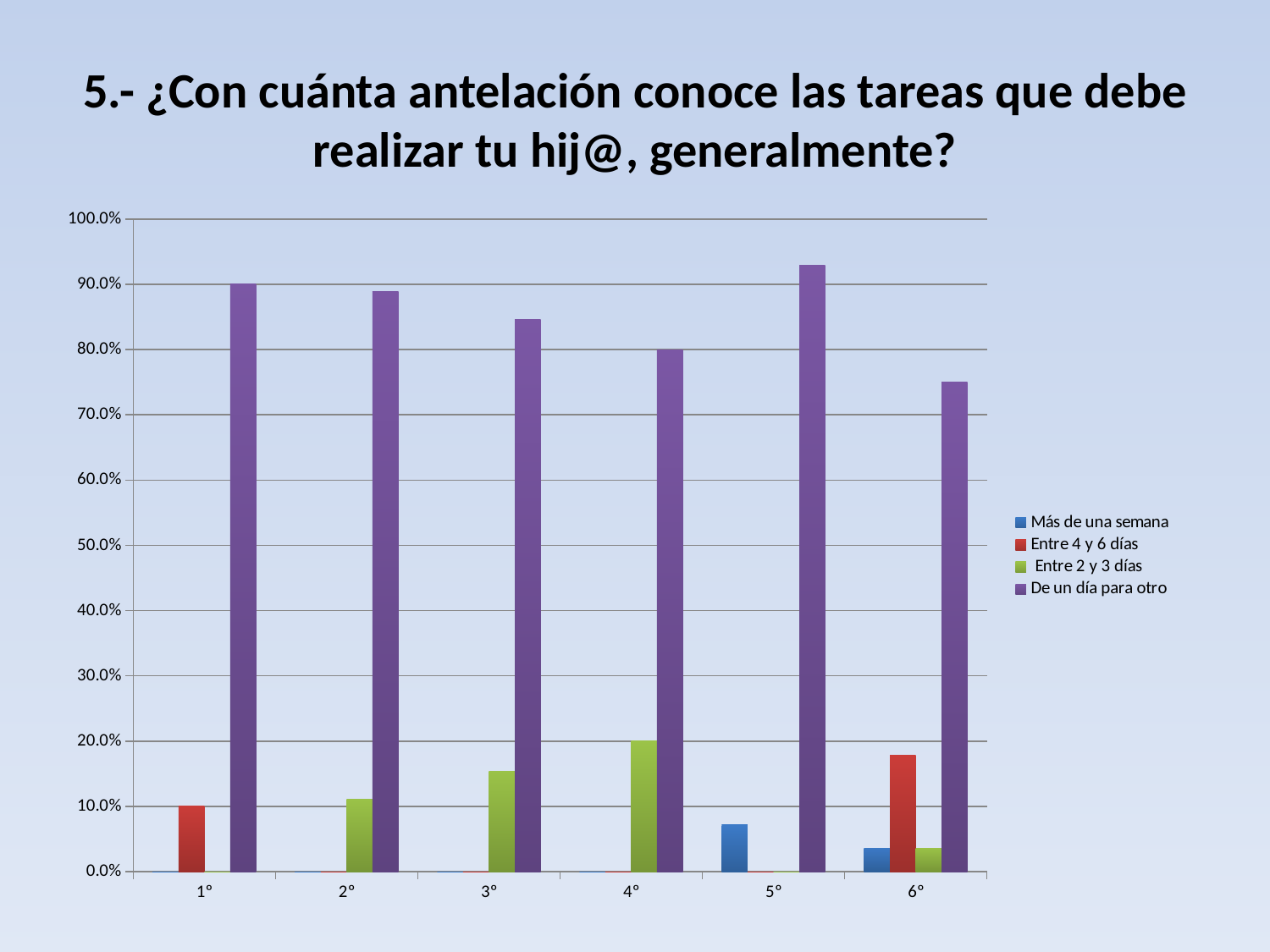
Which colour represents "Entre 2 y 3 días" in the legend? green Which category has the lowest value for "De un día para otro"? 6° Which is larger, the value for "De un día para otro" in category 1° or in category 6°? 1° Is the value for "Más de una semana" in category 5° greater or less than 10.0%? less What kind of chart is shown on the slide? bar chart How many categories are shown on the x axis? 6 How many series does the legend list? 4 What is the value for "De un día para otro" in category 1°? 90.0% Is the value for "De un día para otro" in category 3° greater or less than 80.0%? greater What is the value for "De un día para otro" in category 4°? 80.0% Is the value for "Entre 4 y 6 días" in category 6° greater or less than 10.0%? greater Which category has the highest value for "De un día para otro"? 5°